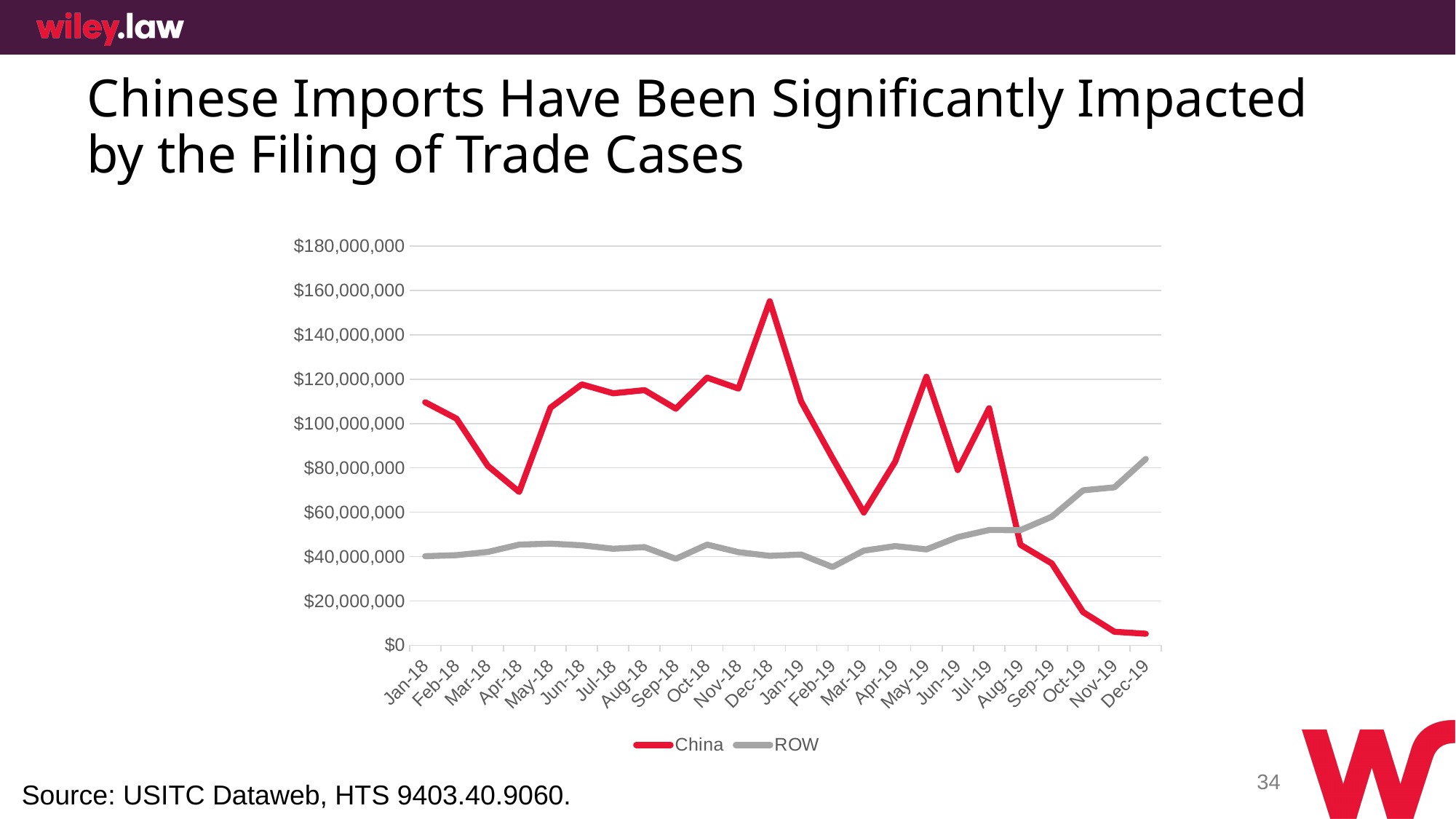
How many months are plotted along the x axis? 24 In which month does the ROW series reach its lowest value? Feb-19 Is the value for China in Apr-18 greater or less than $80,000,000? less Which series has the larger value in Jan-18, China or ROW? China In which month does the China series reach its highest value? Dec-18 Is the value for China in Dec-19 greater or less than $20,000,000? less Is the value for China in Dec-18 greater or less than $140,000,000? greater In which month does the ROW series reach its highest value? Dec-19 How many series does the legend list? 2 Which series has the larger value in Dec-19, China or ROW? ROW Does the China series rise or fall from Jul-19 to Dec-19? fall What kind of chart is shown on the slide? line chart